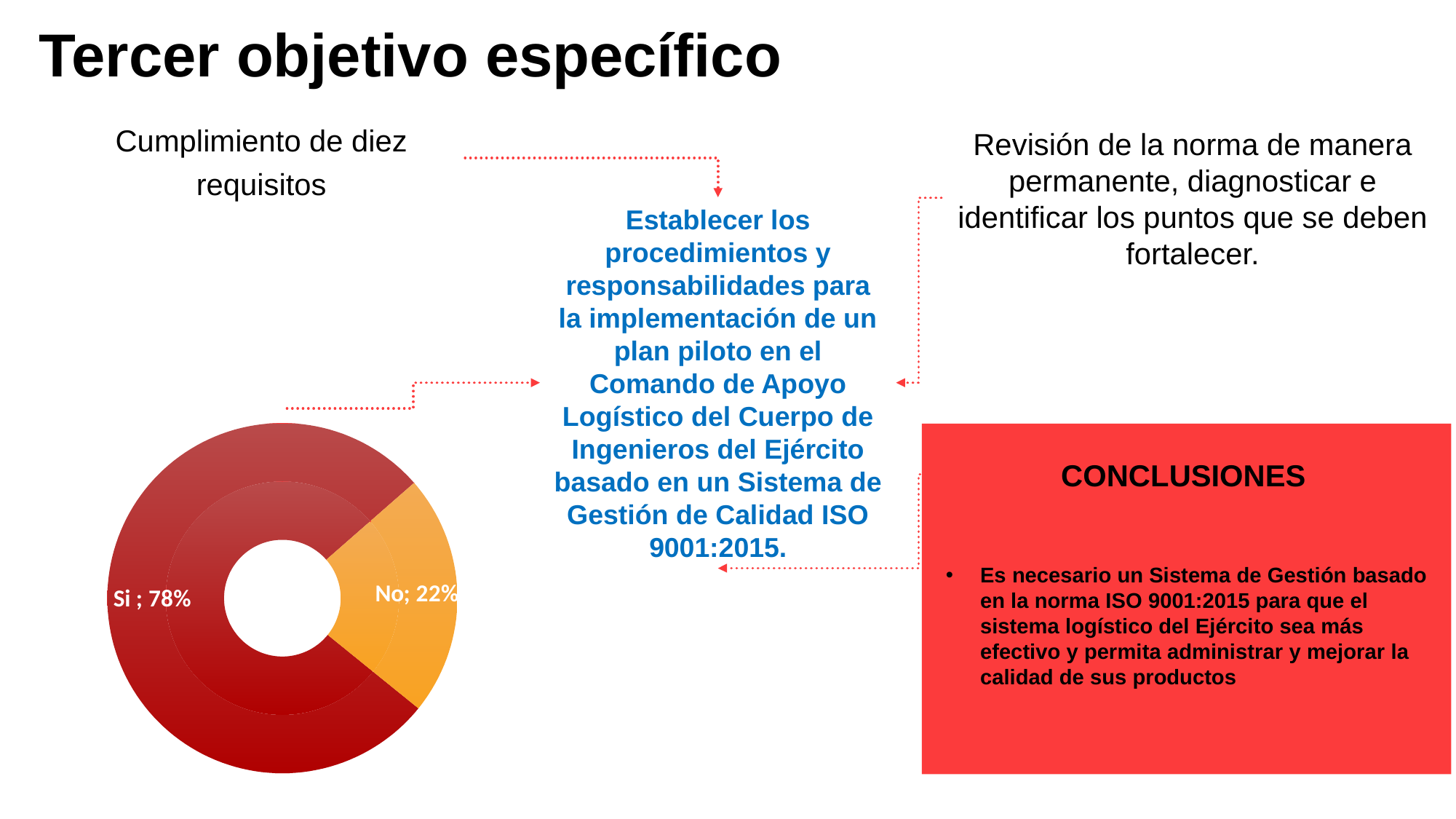
How many slices does the chart have? 2 Which slice of the chart is the smallest? No Which slice of the chart is the largest? Si What is the value shown for the "Si" slice of the chart? 78% What kind of chart is shown on the slide? Doughnut (pie) chart What is the value shown for the "No" slice of the chart? 22% Which is larger in the chart, "Si" or "No"? Si What share of the chart does the "No" slice represent? 22% What colour is the "No" slice in the chart? Orange What colour is the "Si" slice in the chart? Red What is the difference between the "Si" and "No" values in the chart? 56%